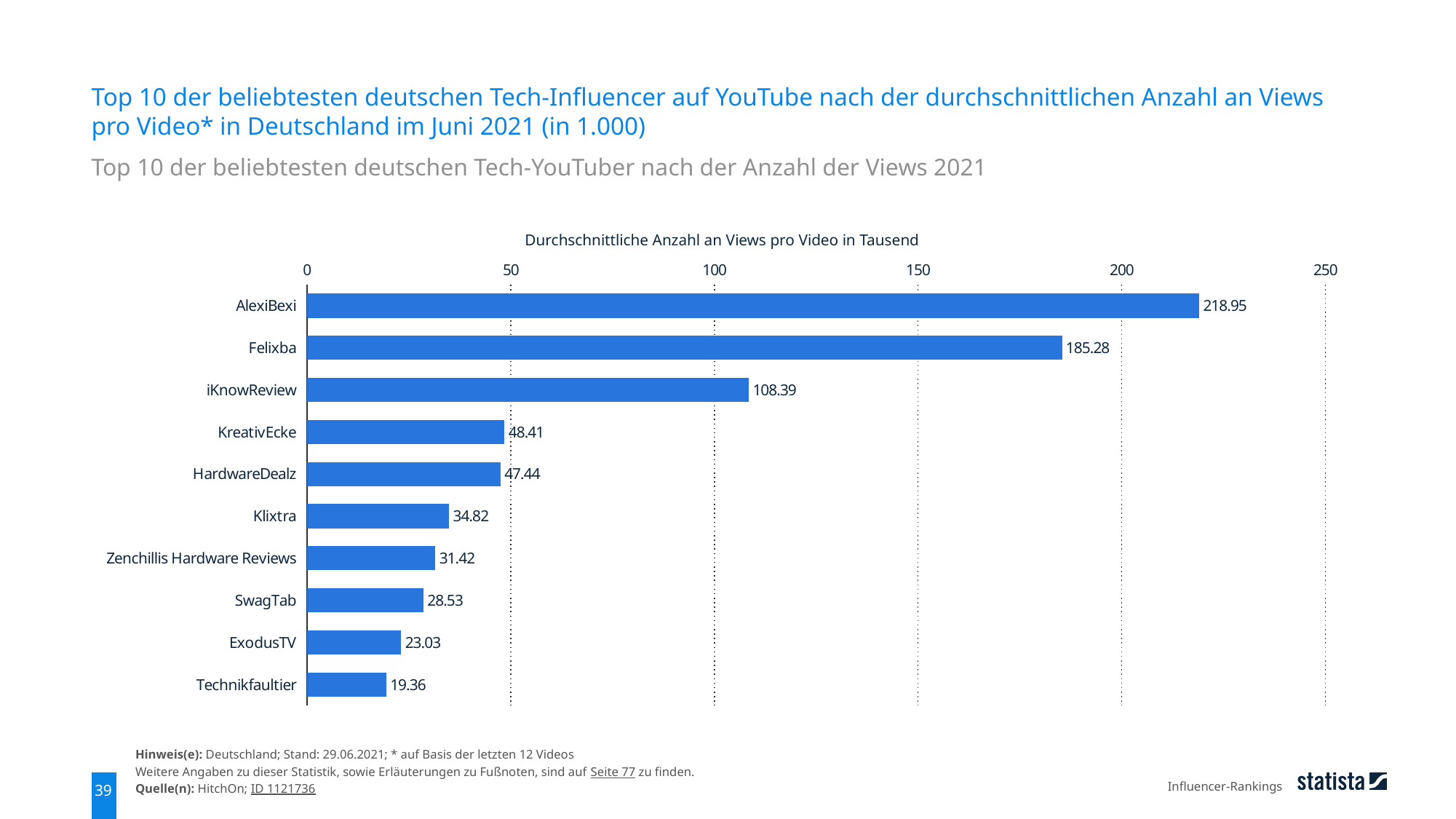
Is the value for Felixba greater or less than 200? less What is the value shown for iKnowReview? 108.39 What is the value shown for ExodusTV? 23.03 What type of chart is shown on the slide? bar chart Which has a larger value, Klixtra or SwagTab? Klixtra What is the average number of views per video (in thousands) for AlexiBexi? 218.95 What is the value shown for Technikfaultier? 19.36 Which YouTuber has the lowest average number of views per video? Technikfaultier What is the axis title shown above the chart? Durchschnittliche Anzahl an Views pro Video in Tausend What is the difference between the values for AlexiBexi and Felixba? 33.67 Which YouTuber has the highest average number of views per video? AlexiBexi How many YouTubers are shown in the chart? 10